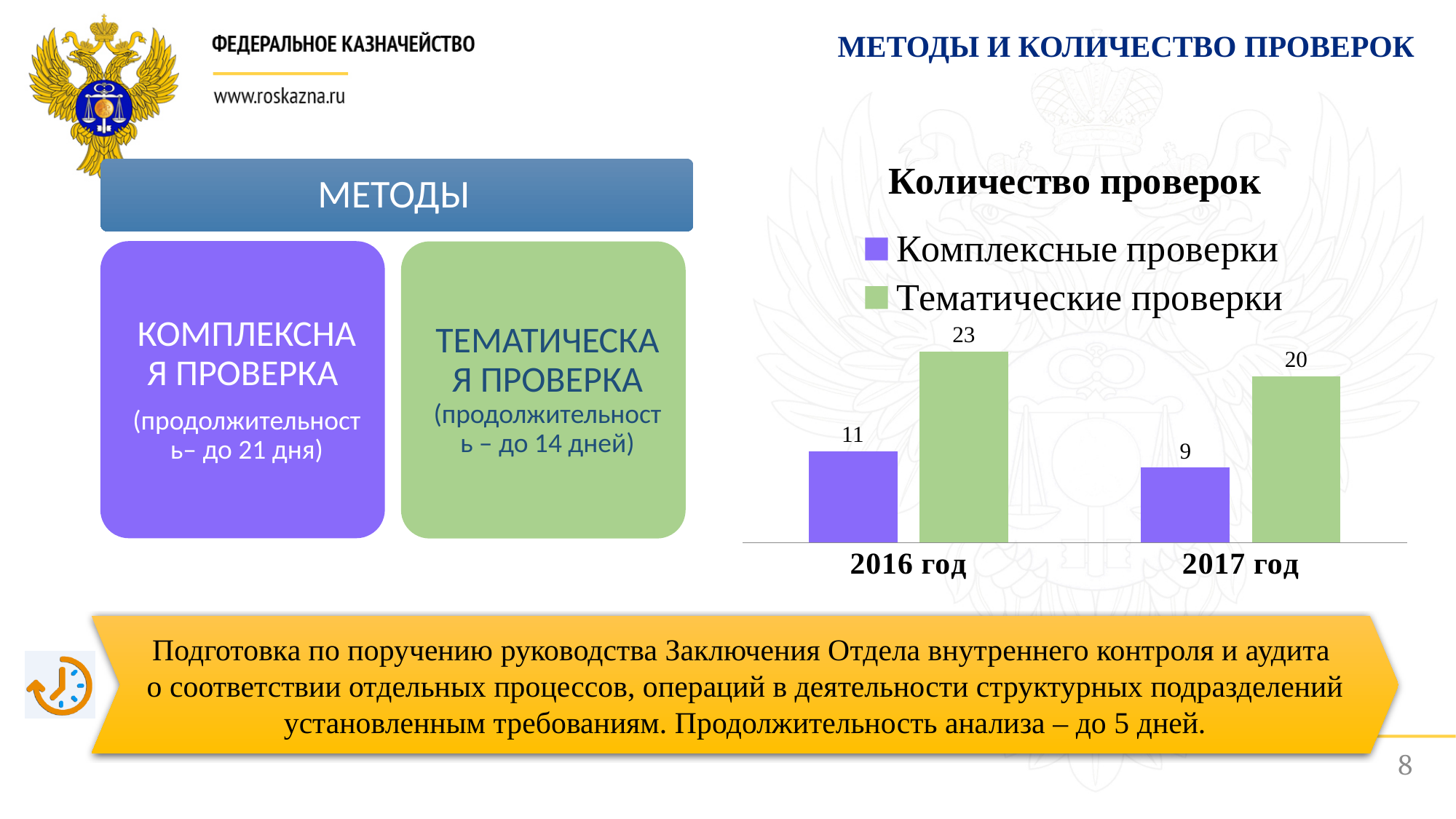
What is the value for Тематические проверки in 2017 год? 20 What is the difference between Тематические проверки and Комплексные проверки in 2016 год? 12 What kind of chart is shown? bar chart Which year has the higher value for Тематические проверки? 2016 год What is the value for Комплексные проверки in 2016 год? 11 Which is larger: Комплексные проверки in 2016 год or Тематические проверки in 2017 год? Тематические проверки in 2017 год What is the difference between Тематические проверки in 2016 год and 2017 год? 3 What is the title of the chart? Количество проверок What is the value for Комплексные проверки in 2017 год? 9 Which year has the lower value for Комплексные проверки? 2017 год How many series does the legend list? 2 What is the value for Тематические проверки in 2016 год? 23